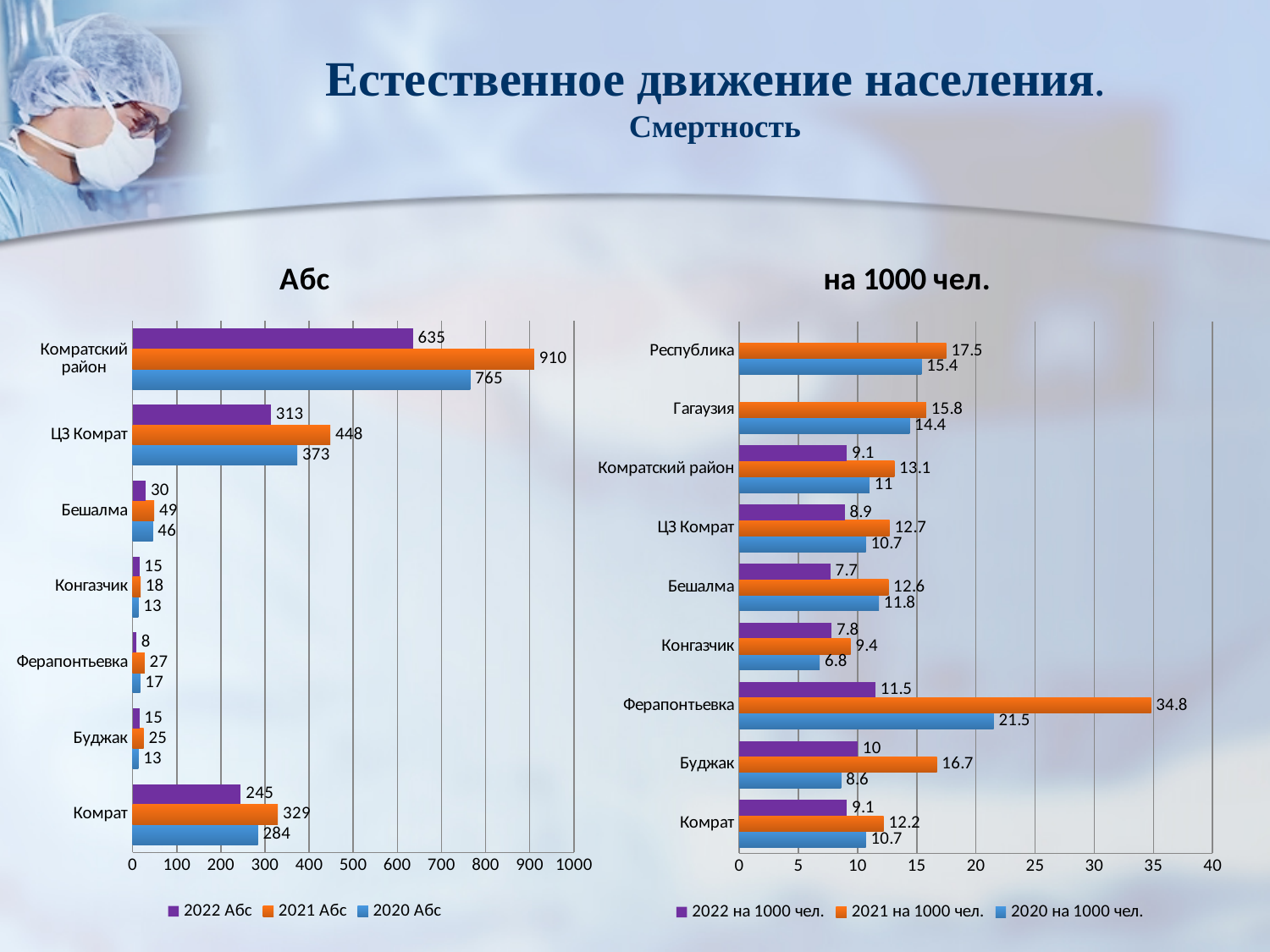
In the 'Абс' chart, which category has the highest 2022 Абс value? Комратский район In the 'Абс' chart, how many categories are shown on the vertical axis? 7 In the 'Абс' chart, what is the difference between the 2021 Абс and 2022 Абс values for Комрат? 84 In the 'на 1000 чел.' chart, which category has the highest 2021 value? Ферапонтьевка In the 'на 1000 чел.' chart, which is larger: the 2022 value for Буджак or the 2022 value for Комрат? Буджак In the 'Абс' chart, what is the 2020 Абс value for ЦЗ Комрат? 373 In the 'Абс' chart, which category has the lowest 2022 Абс value? Ферапонтьевка What type of chart is the 'на 1000 чел.' chart? Bar chart In the 'на 1000 чел.' chart, what is the 2021 value for Ферапонтьевка? 34.8 In the 'на 1000 чел.' chart, what is the 2020 value for Республика? 15.4 In the 'Абс' chart, what is the 2021 Абс value for Комратский район? 910 In the 'на 1000 чел.' chart, how many series does the legend list? 3